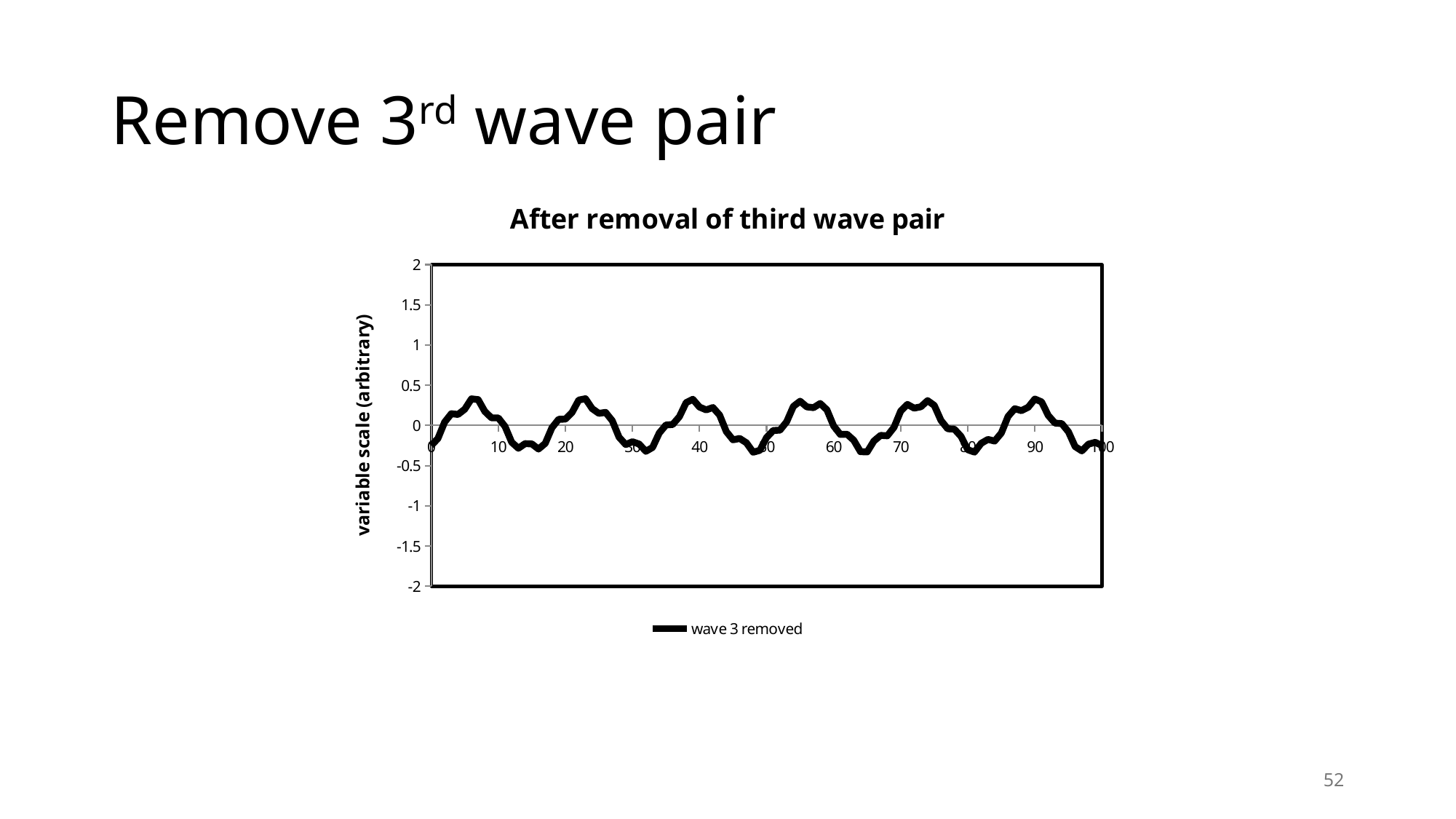
Is the lowest value reached by the line greater or less than -0.5? greater What kind of chart is shown on the slide? line chart How many series does the legend list? 1 Is the lowest value reached by the line greater or less than -1? greater What is the title of the chart? After removal of third wave pair Does the line show a steady rise, a steady fall, or an oscillation along the x axis? oscillation Is the value of the line at x = 40 greater or less than 0? greater What is the name of the series shown in the legend? wave 3 removed